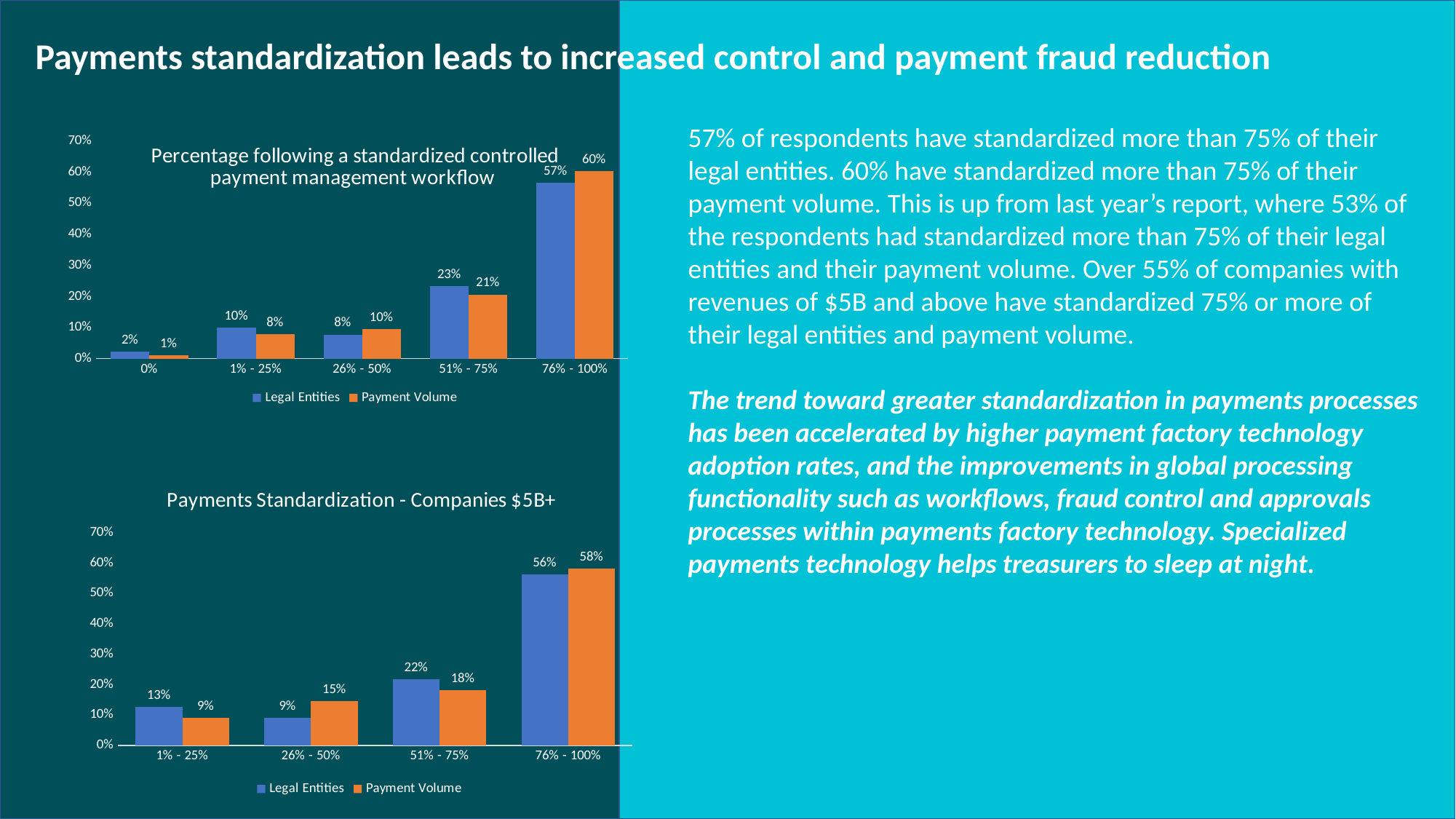
In the bottom chart 'Payments Standardization - Companies $5B+', which is larger for the 51% - 75% category: Legal Entities or Payment Volume? Legal Entities In the top chart 'Percentage following a standardized controlled payment management workflow', how many categories are shown on the x axis? 5 In the top chart 'Percentage following a standardized controlled payment management workflow', what is the Legal Entities value for the 76% - 100% category? 57% In the top chart 'Percentage following a standardized controlled payment management workflow', which category has the highest Payment Volume value? 76% - 100% In the top chart 'Percentage following a standardized controlled payment management workflow', which category has the lowest Legal Entities value? 0% What type of chart is the bottom chart 'Payments Standardization - Companies $5B+'? Bar chart In the bottom chart 'Payments Standardization - Companies $5B+', what is the difference between the Legal Entities and Payment Volume values for the 1% - 25% category? 4% In the top chart 'Percentage following a standardized controlled payment management workflow', what is the difference between the Payment Volume and Legal Entities values for the 76% - 100% category? 3% In the bottom chart 'Payments Standardization - Companies $5B+', how many series does the legend list? 2 In the bottom chart 'Payments Standardization - Companies $5B+', what is the Legal Entities value for the 1% - 25% category? 13% In the top chart 'Percentage following a standardized controlled payment management workflow', what is the Payment Volume value for the 51% - 75% category? 21% In the bottom chart 'Payments Standardization - Companies $5B+', what is the Payment Volume value for the 26% - 50% category? 15%